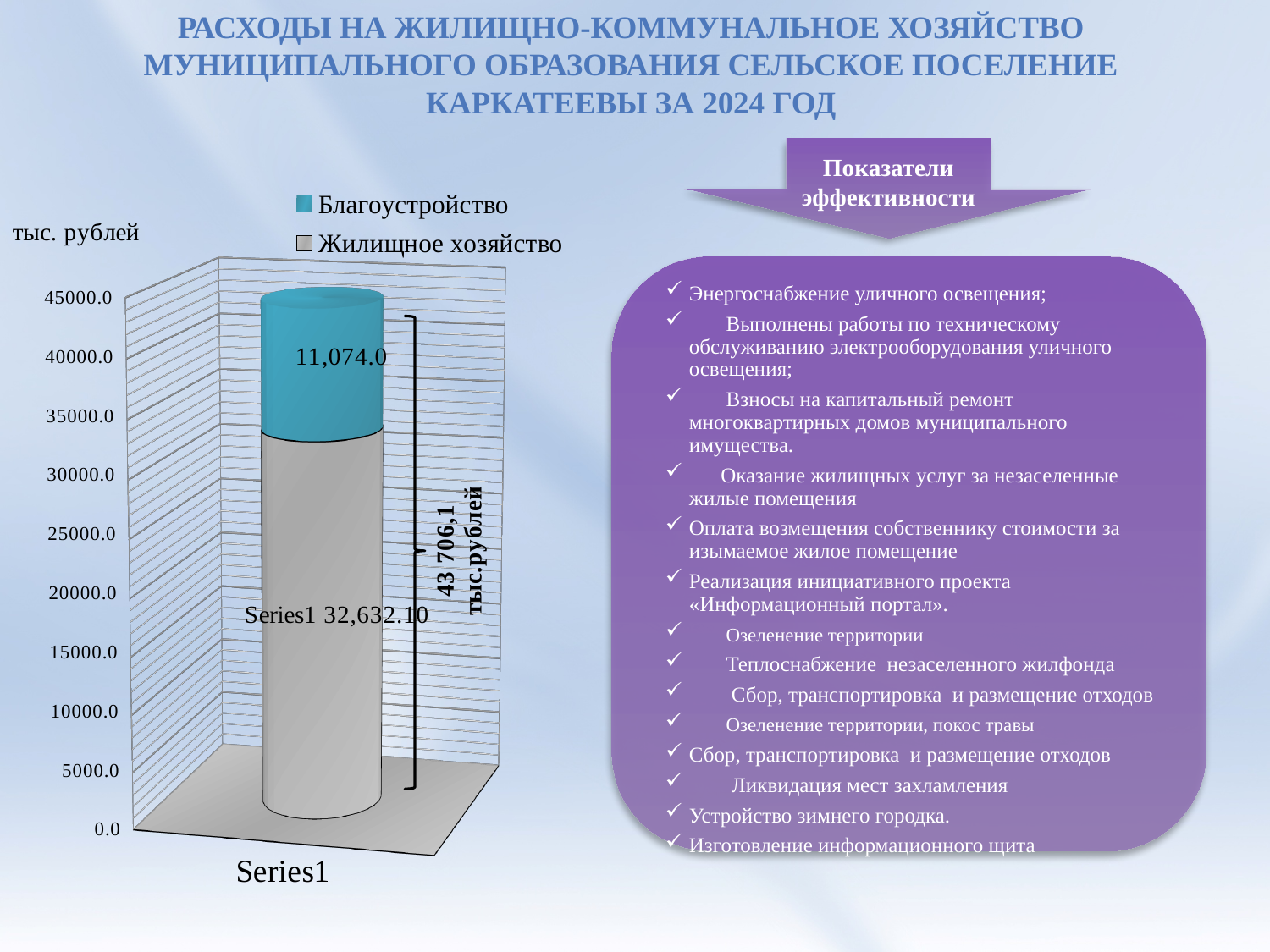
What is the total of the stacked bar, as annotated on the chart? 43 706,1 тыс.рублей What is the value of the Жилищное хозяйство segment in the chart? 32,632.10 What unit label is shown above the vertical axis of the chart? тыс. рублей What kind of chart is shown on the slide? Stacked bar chart What is the value of the Благоустройство segment in the chart? 11,074.0 Is the Благоустройство value greater or less than 15000.0? less Which series has the larger value in the chart, Благоустройство or Жилищное хозяйство? Жилищное хозяйство How many series does the chart legend list? 2 Is the total height of the stacked bar greater or less than 40000.0? greater How many categories are plotted on the x axis of the chart? 1 What is the difference between the Жилищное хозяйство value and the Благоустройство value? 21,558.10 Which colour represents Благоустройство in the chart legend? Teal (blue-green)